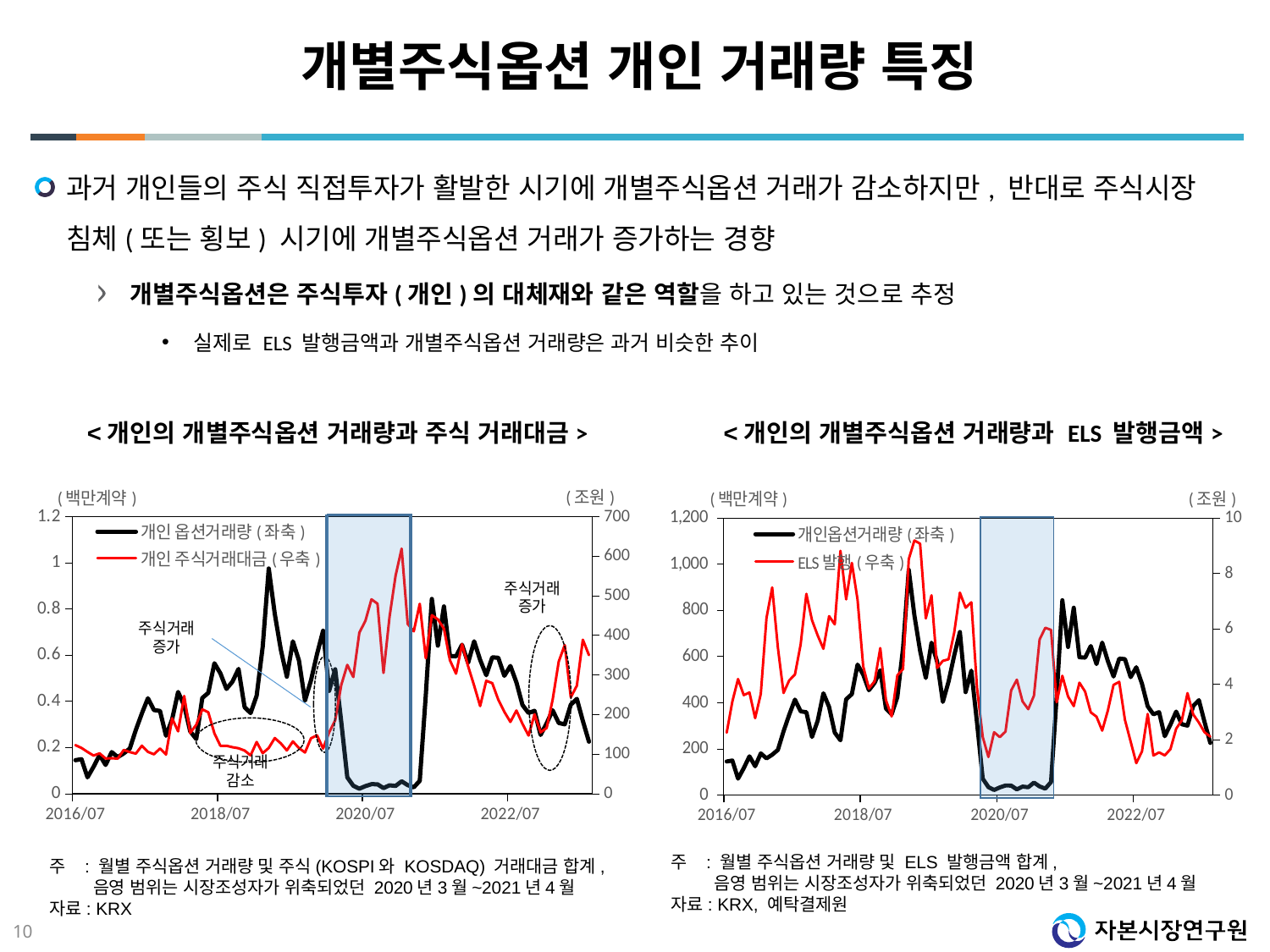
How many series does the legend of the right chart list? 2 What kind of chart is the right chart titled '개인의 개별주식옵션 거래량과 ELS 발행금액'? line chart In the left chart, is the peak value of 개인 주식거래대금 (우축) within the shaded period greater or less than 500? greater In the left chart, is the value of 개인 옵션거래량 (좌축) during the shaded period around 2020/07 greater or less than 0.2? less What kind of chart is the left chart titled '개인의 개별주식옵션 거래량과 주식 거래대금'? line chart How many series does the legend of the left chart list? 2 In the left chart, does 개인 옵션거래량 (좌축) generally rise or fall from its peak after the shaded period toward the end of the series? fall In the right chart, does ELS 발행 (우축) generally rise or fall from the end of the shaded period toward 2022/07? fall In the right chart, which series is plotted on the right axis (우축)? ELS 발행 In the right chart, is the value of 개인옵션거래량 (좌축) during the shaded period around 2020/07 greater or less than 200? less In the left chart, what unit is shown for the left axis? 백만계약